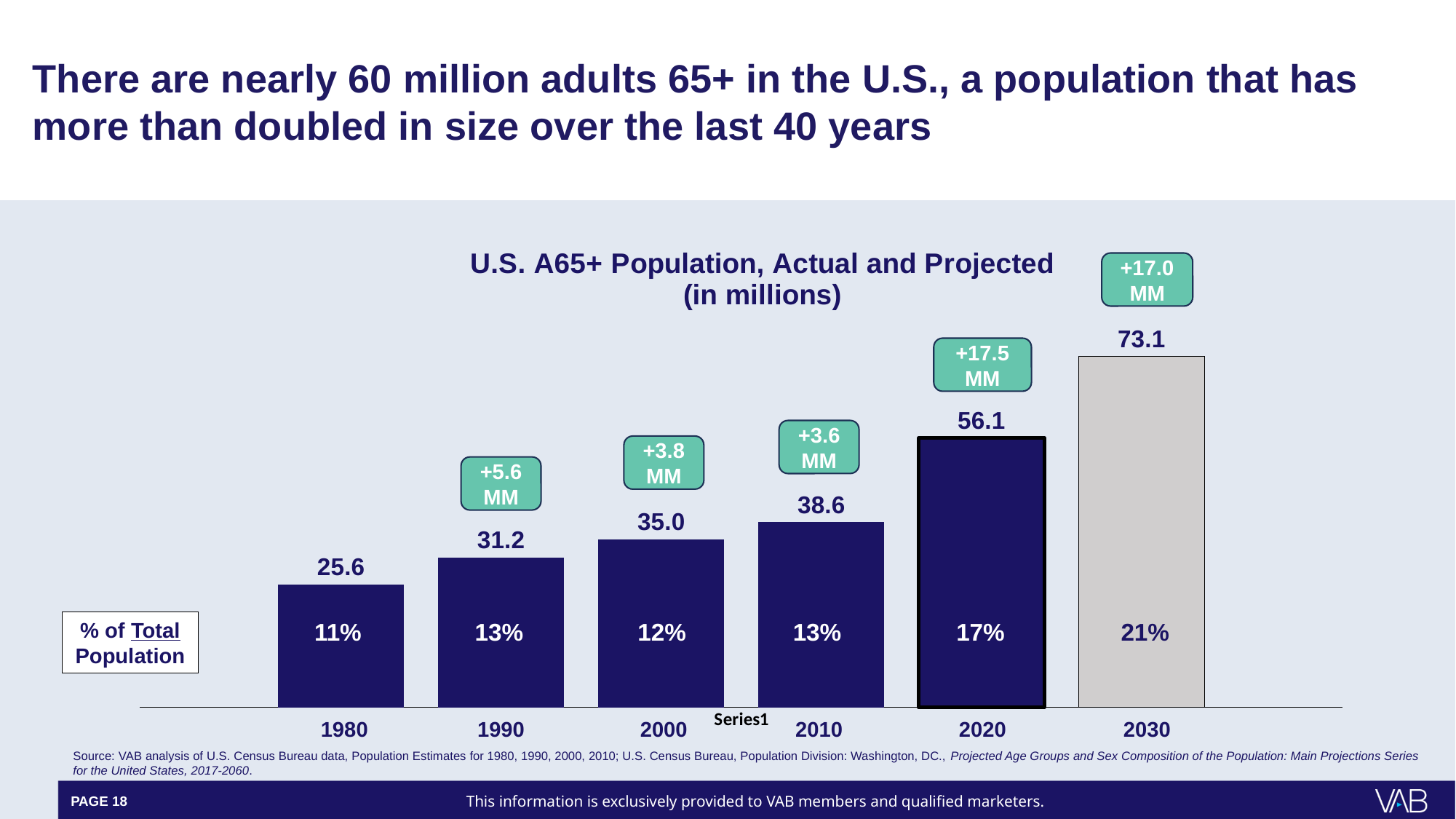
Which year has the lowest A65+ population value? 1980 What percentage of the total population is shown for 1980? 11% Do the A65+ population values rise or fall from 1980 to 2030? Rise What is the difference between the 2030 value and the 2020 value? 17.0 What is the U.S. A65+ population value shown for 2020? 56.1 How many years (bars) are shown in the chart? 6 What type of chart is shown on the slide? Bar chart What is the value shown for 1980? 25.6 What percentage of the total population does the 2030 bar show? 21% Which year has the highest A65+ population value? 2030 What is the difference between the 2010 value and the 2000 value? 3.6 Which is larger, the value for 1990 or the value for 2000? 2000